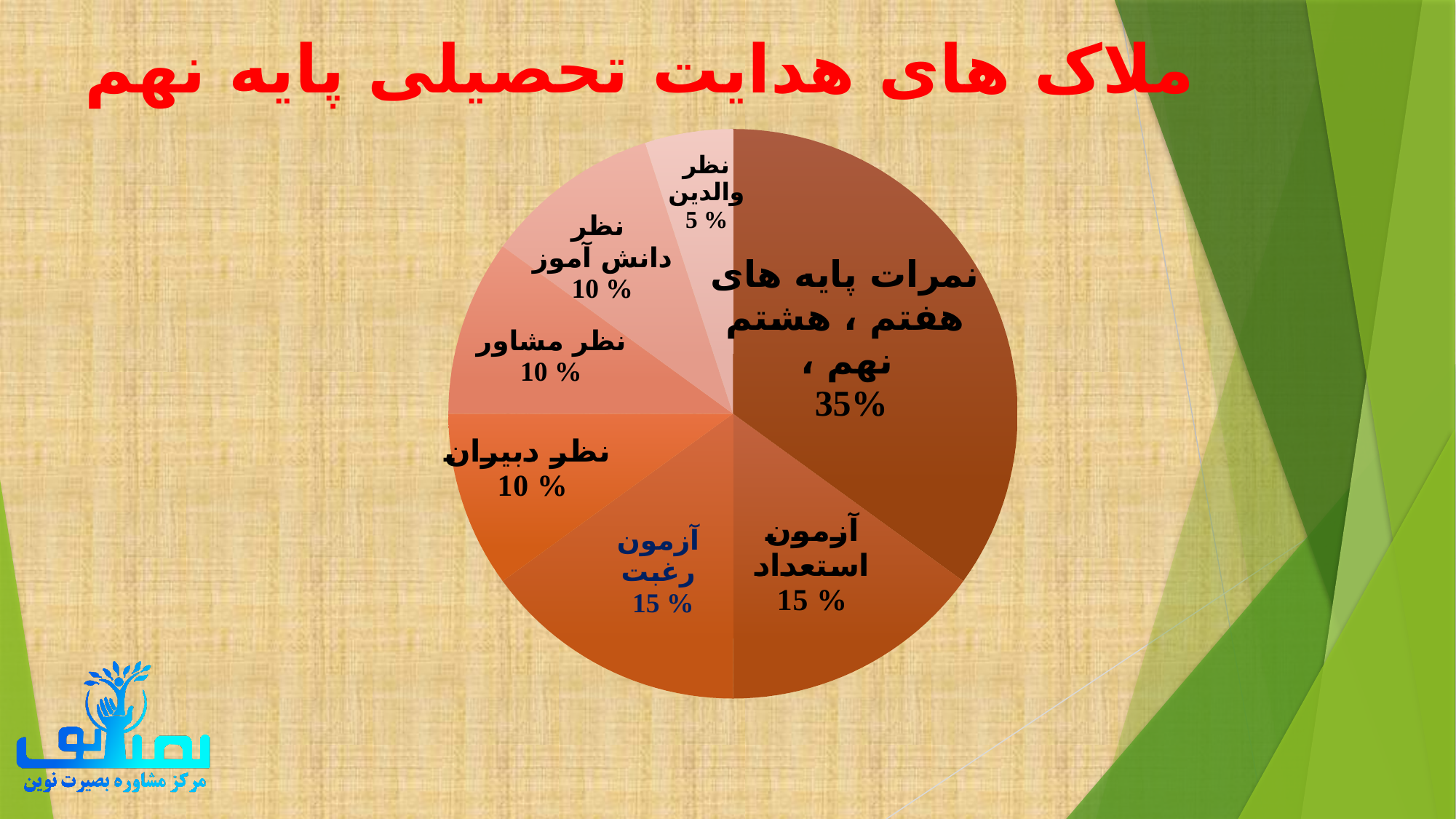
Which slice of the pie is the largest? نمرات پایه های هفتم ، هشتم ، نهم What is the value shown for نظر مشاور? 10 % What kind of chart is shown on the slide? pie chart How many slices does the pie chart have? 7 What is the combined share of نظر دبیران, نظر مشاور and نظر دانش آموز? 30% What is the value shown for نظر والدین? 5 % What is the difference between the share for نمرات پایه های هفتم ، هشتم ، نهم and the share for آزمون رغبت? 20% What share of the pie is labelled نمرات پایه های هفتم ، هشتم ، نهم? 35% Which is larger, the share for آزمون رغبت or the share for نظر دبیران? آزمون رغبت Which slice of the pie is the smallest? نظر والدین What is the value shown for آزمون استعداد? 15 % What is the title of the chart? ملاک های هدایت تحصیلی پایه نهم